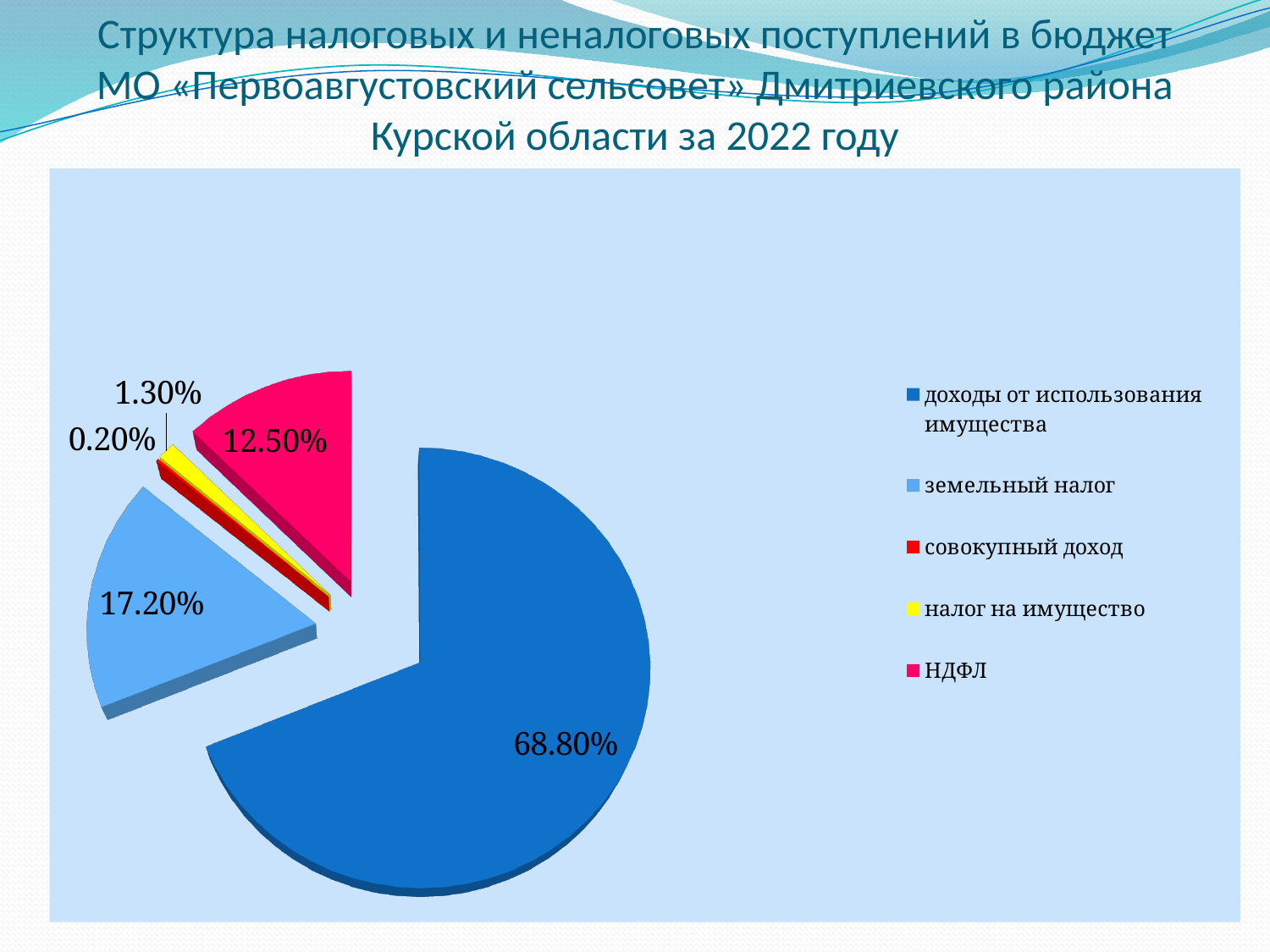
What share of the pie is доходы от использования имущества? 68.80% What is the difference between the shares of доходы от использования имущества and земельный налог? 51.60% What is the value shown for НДФЛ? 12.50% Which category has the smallest slice of the pie? совокупный доход What is the value shown for земельный налог? 17.20% How many slices does the pie chart have? 5 What is the difference between the shares of земельный налог and НДФЛ? 4.70% What is the value shown for налог на имущество? 1.30% Which category has the largest slice of the pie? доходы от использования имущества What colour is the slice for НДФЛ? pink Which is larger, земельный налог or НДФЛ? земельный налог What kind of chart is shown on the slide? pie chart